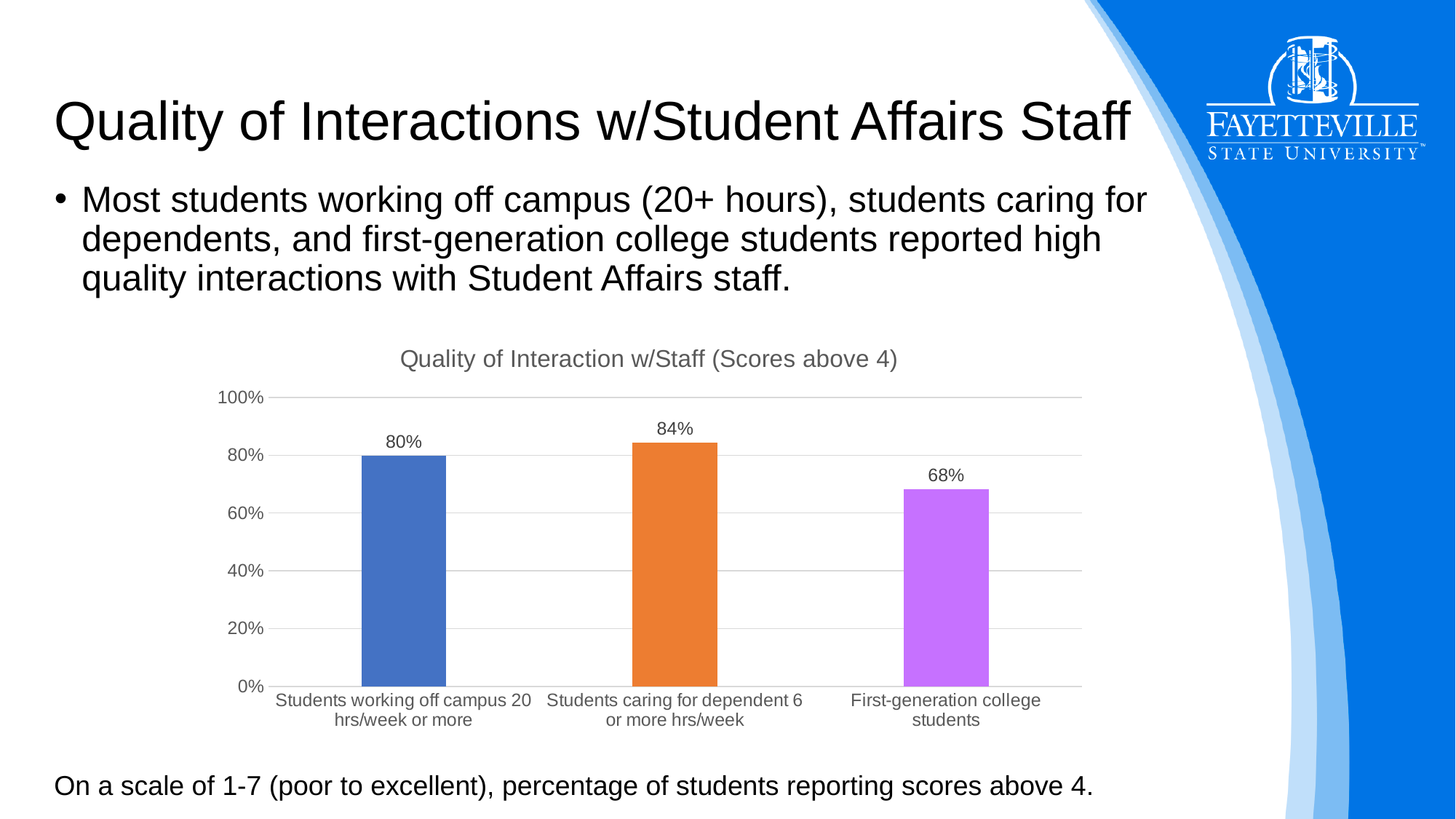
What is the difference between the values for Students caring for dependent 6 or more hrs/week and First-generation college students? 16% What kind of chart is shown on the slide? bar chart What is the value for Students working off campus 20 hrs/week or more? 80% What is the value for Students caring for dependent 6 or more hrs/week? 84% How many categories are shown in the chart? 3 What is the title of the chart? Quality of Interaction w/Staff (Scores above 4) What is the difference between the values for Students caring for dependent 6 or more hrs/week and Students working off campus 20 hrs/week or more? 4% Which is larger, the value for Students working off campus 20 hrs/week or more or the value for First-generation college students? Students working off campus 20 hrs/week or more What is the value for First-generation college students? 68% Is the value for First-generation college students greater or less than 60%? greater Which category has the highest value? Students caring for dependent 6 or more hrs/week Which category has the lowest value? First-generation college students